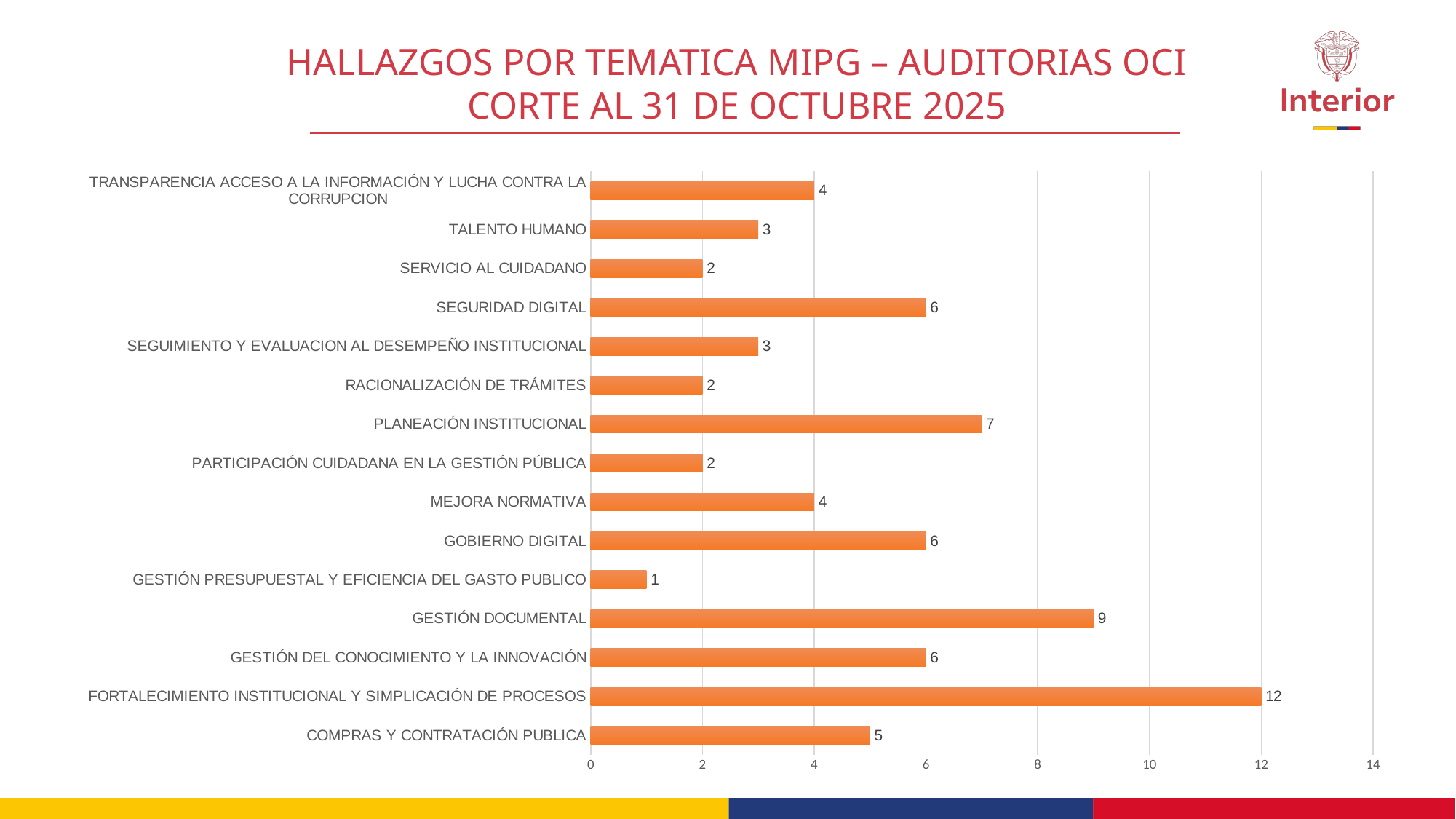
Is the value for GESTIÓN DOCUMENTAL greater or less than 8? greater What is the difference between the values for GOBIERNO DIGITAL and SERVICIO AL CUIDADANO? 4 Which is larger, the value for SEGURIDAD DIGITAL or the value for TALENTO HUMANO? SEGURIDAD DIGITAL What is the value for COMPRAS Y CONTRATACIÓN PUBLICA? 5 What kind of chart is shown on the slide? bar chart Which category has the lowest value? GESTIÓN PRESUPUESTAL Y EFICIENCIA DEL GASTO PUBLICO What is the difference between the values for FORTALECIMIENTO INSTITUCIONAL Y SIMPLICACIÓN DE PROCESOS and GESTIÓN DOCUMENTAL? 3 What is the value for PLANEACIÓN INSTITUCIONAL? 7 Which category has the highest value? FORTALECIMIENTO INSTITUCIONAL Y SIMPLICACIÓN DE PROCESOS How many categories are shown in the chart? 15 What is the value for GESTIÓN DOCUMENTAL? 9 What is the title of the chart on the slide? HALLAZGOS POR TEMATICA MIPG – AUDITORIAS OCI CORTE AL 31 DE OCTUBRE 2025